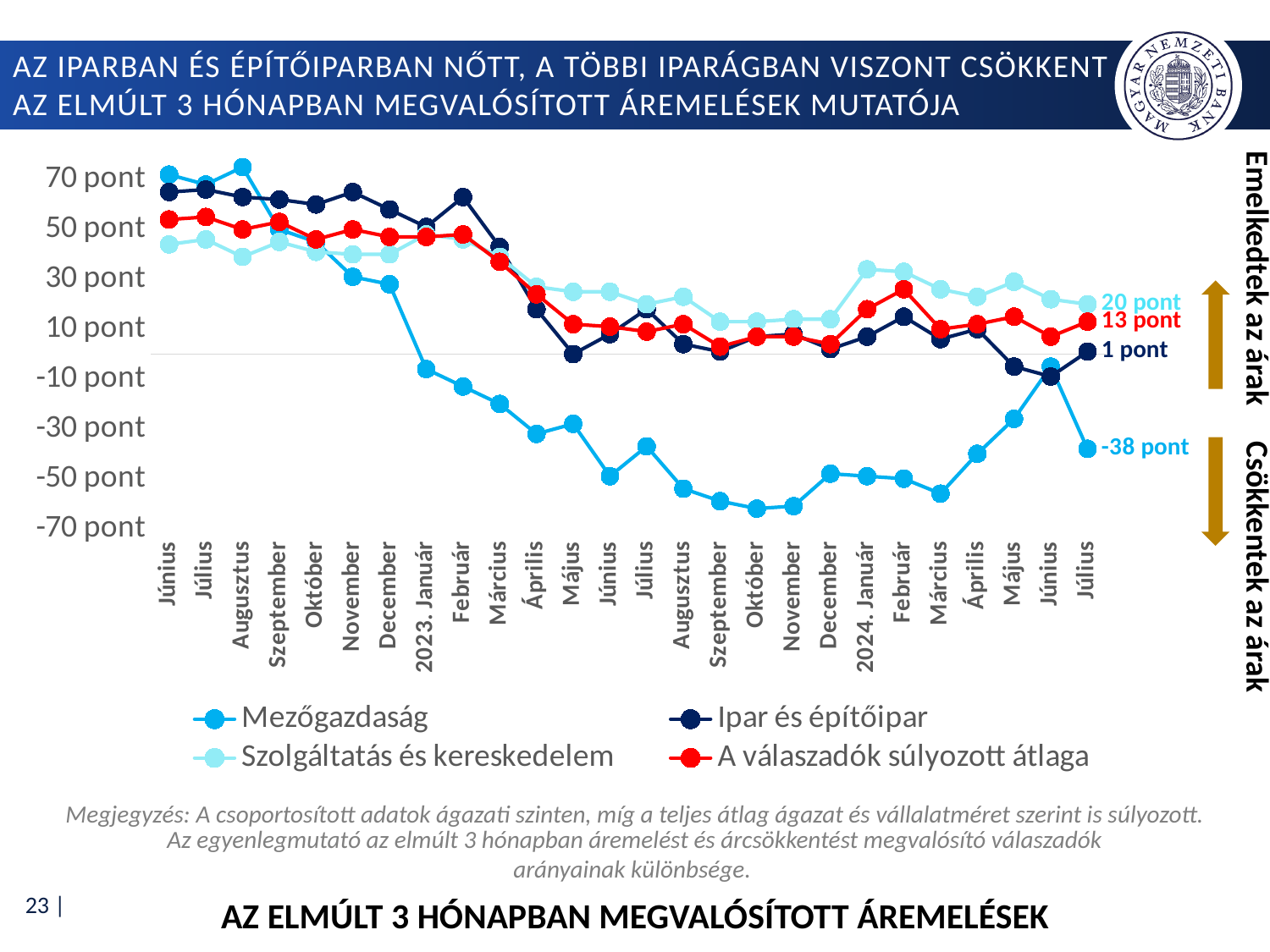
Does the Mezőgazdaság series overall rise or fall from Június 2022 to Július 2024? fall What is the value for Szolgáltatás és kereskedelem at the last point (Július 2024)? 20 pont Is the value for Mezőgazdaság in Október 2023 greater or less than -50 pont? less Which series has the highest value at the last point (Július 2024)? Szolgáltatás és kereskedelem What is the value for A válaszadók súlyozott átlaga at the last point (Július 2024)? 13 pont Which series is drawn in red in the legend? A válaszadók súlyozott átlaga What kind of chart is shown on the slide? line chart Which series has the lowest value at the last point (Július 2024)? Mezőgazdaság How many series does the legend list? 4 What is the value for Mezőgazdaság at the last point (Július 2024)? -38 pont What is the value for Ipar és építőipar at the last point (Július 2024)? 1 pont What is the difference between the final values of Szolgáltatás és kereskedelem (20 pont) and A válaszadók súlyozott átlaga (13 pont)? 7 pont